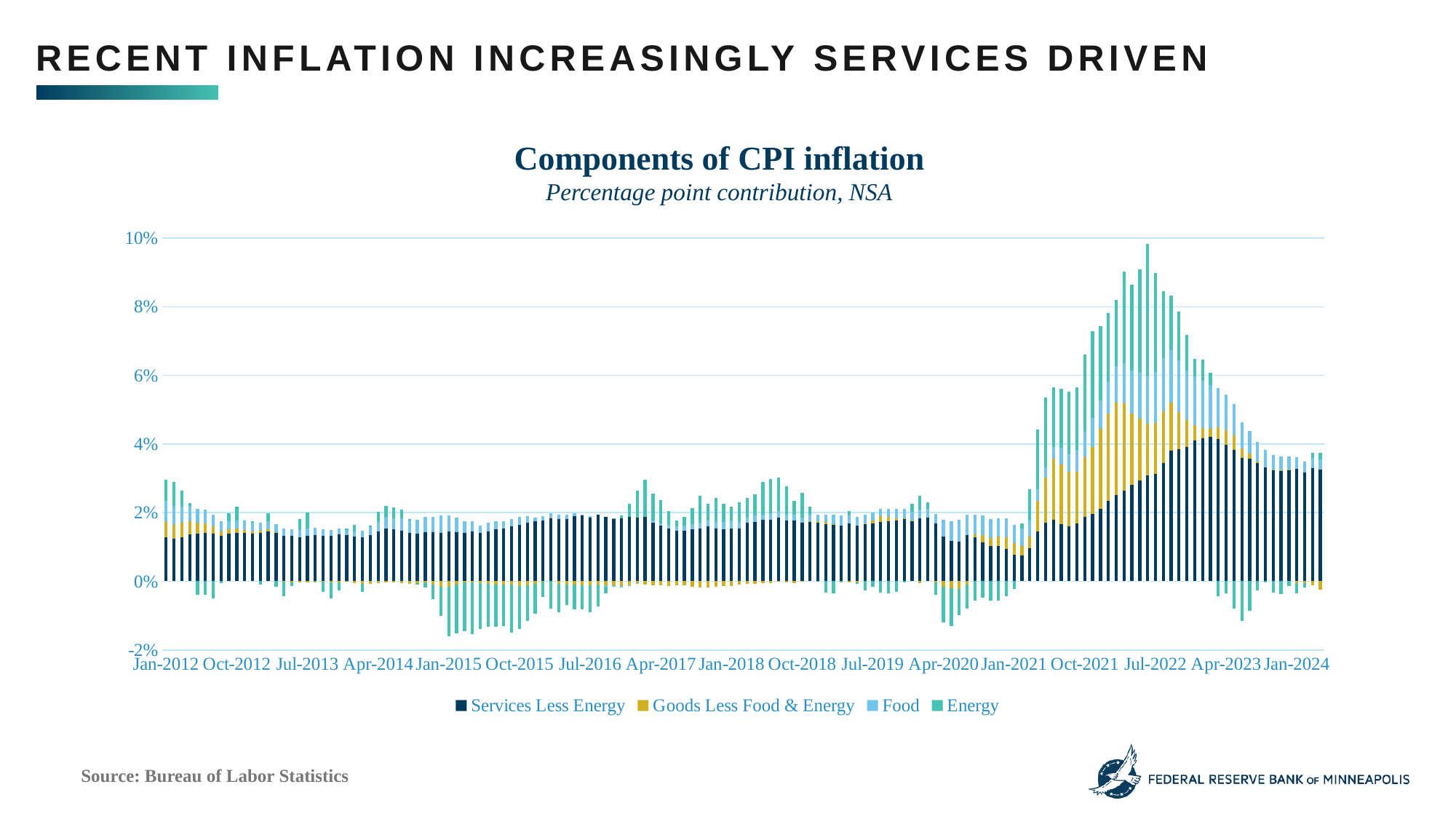
Which series makes the largest contribution to the stacked bar at Jan-2024? Services Less Energy Is the Energy contribution at Jan-2015 greater or less than 0%? less Is the total height of the stacked bar at Jul-2022 greater or less than 8%? greater What is the lowest value shown on the y axis of the chart? -2% What is the highest value shown on the y axis of the chart? 10% Which series in the chart is shown in dark navy? Services Less Energy Is the Services Less Energy contribution at Jan-2024 greater or less than 2%? greater What is the title of the chart? Components of CPI inflation What kind of chart is shown on the slide? bar chart From Jul-2022 to Jan-2024, do the total heights of the stacked bars rise or fall? fall How many series does the legend of the chart list? 4